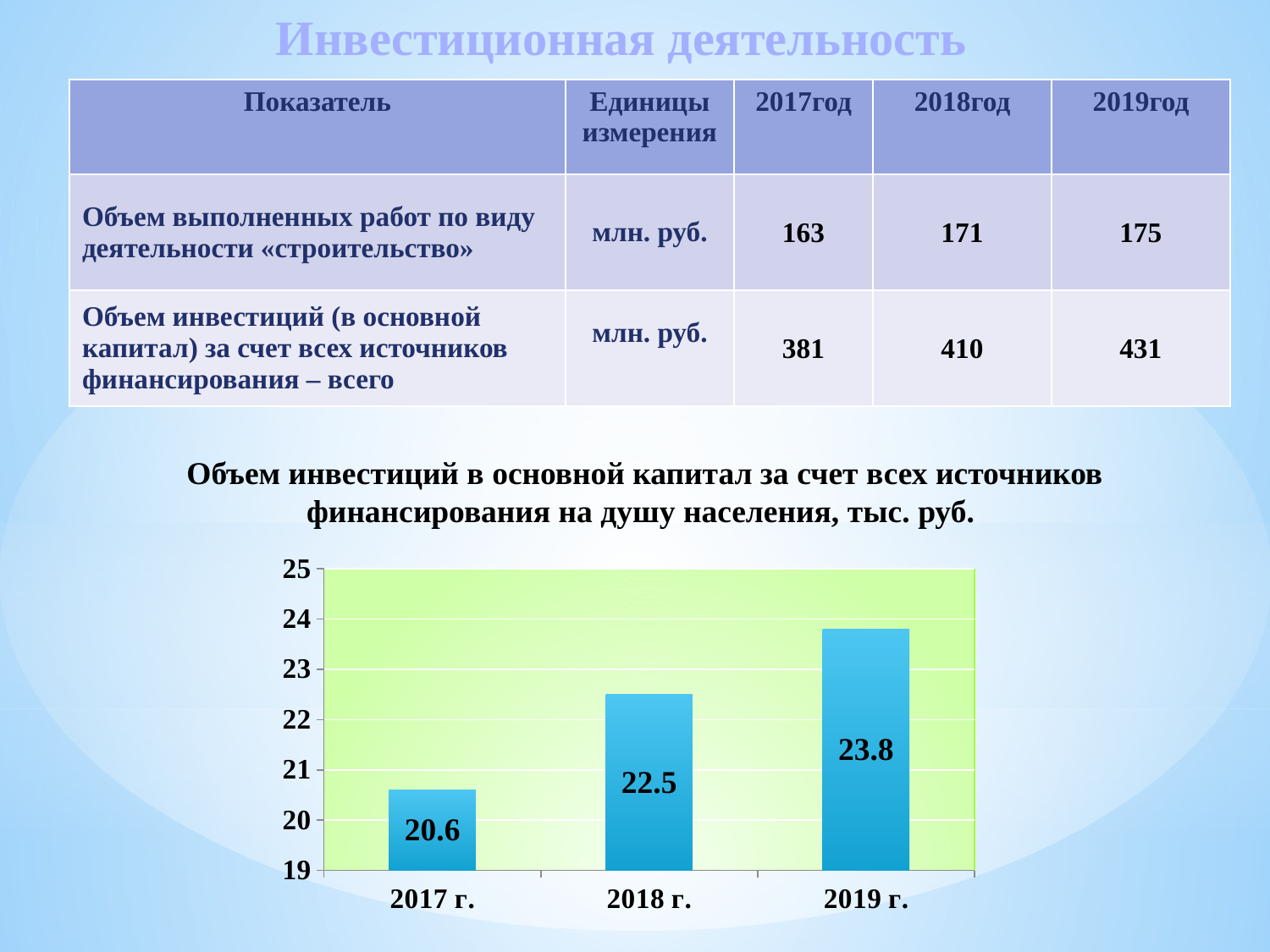
What kind of chart is shown on the slide? bar chart What is the value for 2019 г. in the chart? 23.8 Do the values rise or fall from 2017 г. to 2019 г.? rise Which is larger, the value for 2018 г. or the value for 2019 г.? 2019 г. How many bars are shown in the chart? 3 Which year has the lowest value in the chart? 2017 г. What is the difference between the values for 2019 г. and 2017 г.? 3.2 Is the value for 2018 г. greater or less than 22? greater What is the value for 2017 г. in the chart? 20.6 What is the value for 2018 г. in the chart? 22.5 Which year has the highest value in the chart? 2019 г. What is the difference between the values for 2018 г. and 2017 г.? 1.9